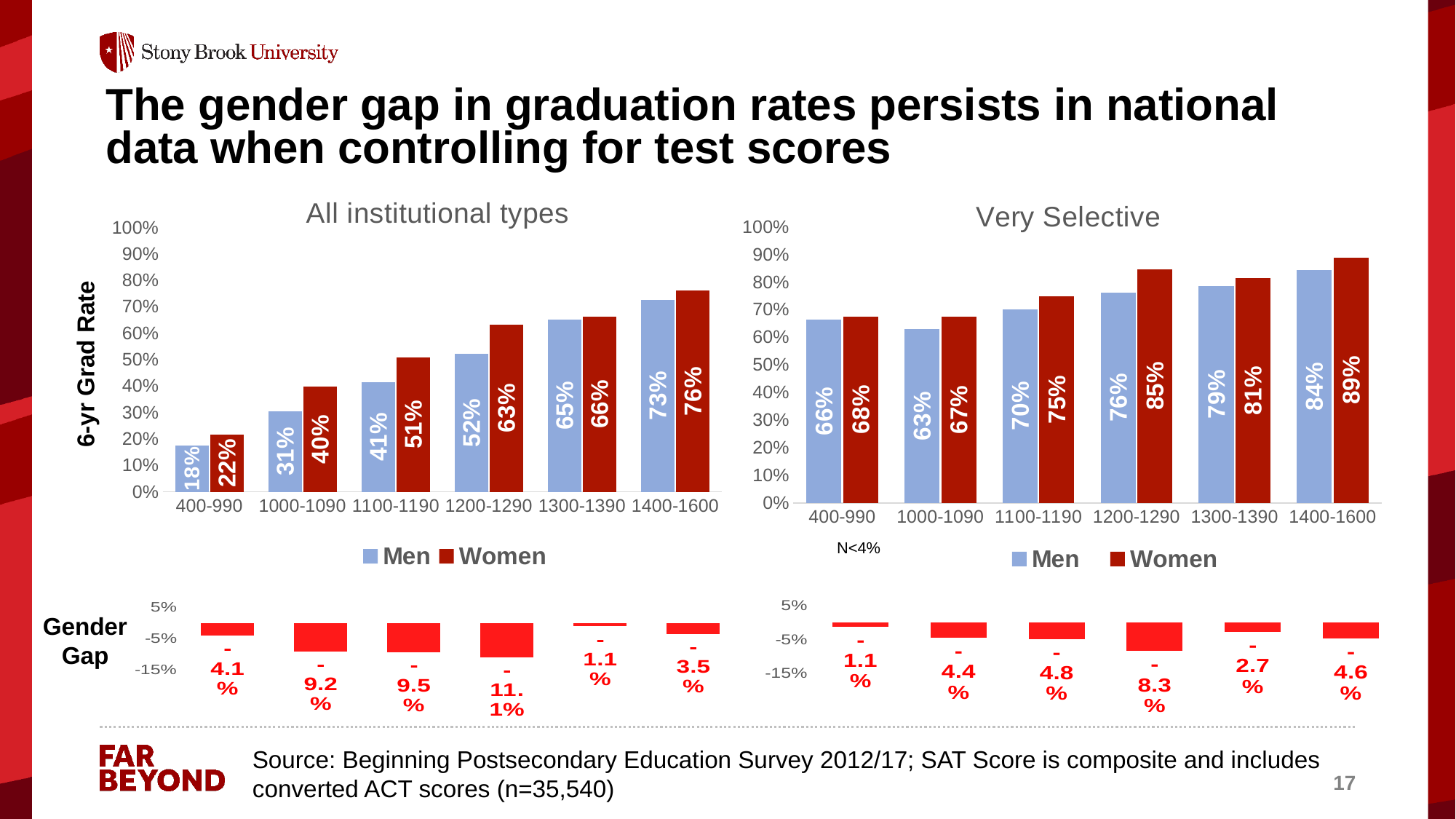
In the 'Very Selective' chart, which SAT range has the lowest grad rate for Men? 1000-1090 In the Gender Gap chart below 'All institutional types', what is the gender gap value for the 1200-1290 SAT range? -11.1% In the 'All institutional types' chart, what is the 6-yr grad rate for Women in the 1200-1290 SAT range? 63% What are the two legend entries in the 'Very Selective' chart? Men and Women What kind of chart is the 'All institutional types' chart? Bar chart In the 'All institutional types' chart, which SAT range has the highest grad rate for Women? 1400-1600 How many SAT score ranges are shown on the x axis of the 'All institutional types' chart? 6 In the 'All institutional types' chart, do the Men's grad rates rise or fall as the SAT range increases along the x axis? Rise In the 'Very Selective' chart, which series has the higher grad rate in the 1300-1390 SAT range, Men or Women? Women How many series does the legend of the 'Very Selective' chart list? 2 In the 'All institutional types' chart, how much higher is the Women's grad rate than the Men's in the 1100-1190 SAT range? 10% In the 'Very Selective' chart, what is the 6-yr grad rate for Men in the 1000-1090 SAT range? 63%